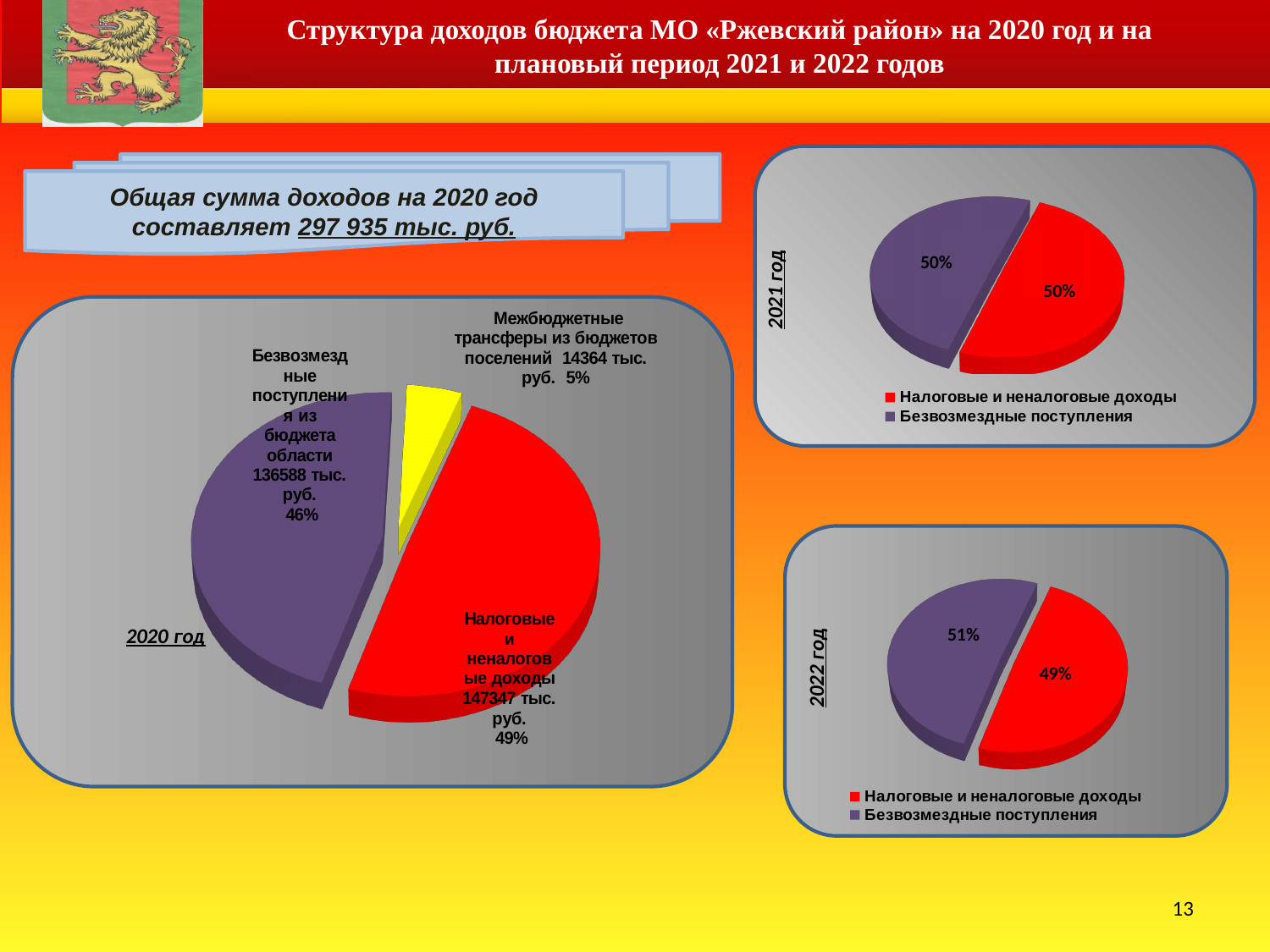
How many entries does the legend of the 2021 год pie chart list? 2 In the 2021 год pie chart, what is the share of Налоговые и неналоговые доходы? 50% How many slices does the 2020 год pie chart have? 3 In the 2020 год pie chart, what percentage share do Межбюджетные трансферы из бюджетов поселений have? 5% In the 2020 год pie chart, what is the difference between Налоговые и неналоговые доходы and Безвозмездные поступления из бюджета области in тыс. руб.? 10759 тыс. руб. In the 2022 год pie chart, which is larger: Налоговые и неналоговые доходы or Безвозмездные поступления? Безвозмездные поступления In the 2020 год pie chart, what is the value for Налоговые и неналоговые доходы? 147347 тыс. руб. In the 2022 год pie chart, what is the share of Безвозмездные поступления? 51% In the 2020 год pie chart, which category has the largest slice? Налоговые и неналоговые доходы What kind of chart is used for the 2021 год data? Pie chart In the 2020 год pie chart, which category has the smallest slice? Межбюджетные трансферы из бюджетов поселений In the 2022 год pie chart, what colour represents Налоговые и неналоговые доходы? Red